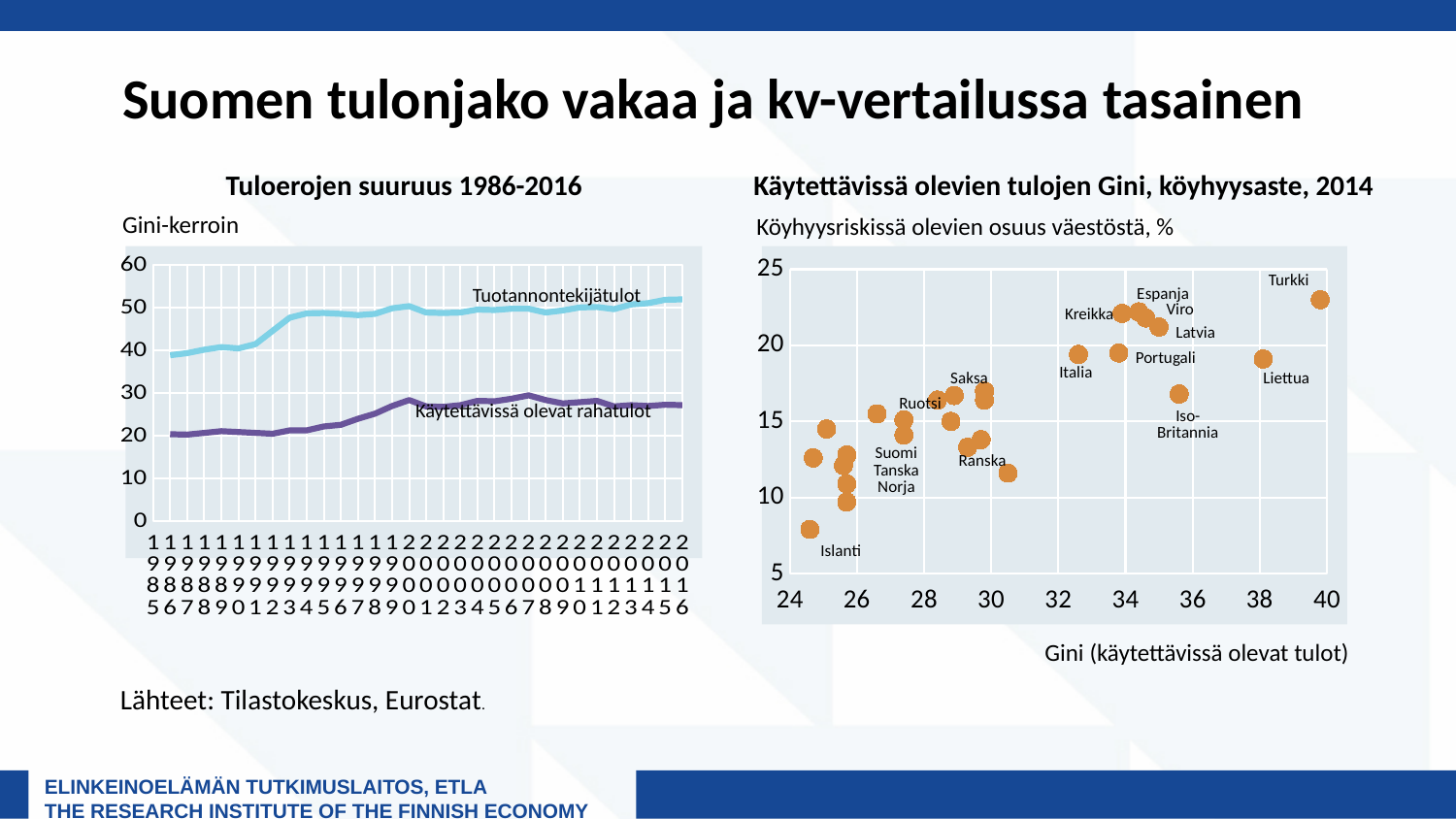
In the left chart, 'Tuloerojen suuruus 1986-2016', which series has the higher values throughout, Tuotannontekijätulot or Käytettävissä olevat rahatulot? Tuotannontekijätulot In the left chart, 'Tuloerojen suuruus 1986-2016', is the value for Käytettävissä olevat rahatulot in 1986 greater or less than 30? less What is the x-axis label of the right chart, 'Käytettävissä olevien tulojen Gini, köyhyysaste, 2014'? Gini (käytettävissä olevat tulot) In the right chart, 'Käytettävissä olevien tulojen Gini, köyhyysaste, 2014', is the poverty-risk share for Islanti greater or less than 10? less In the right chart, 'Käytettävissä olevien tulojen Gini, köyhyysaste, 2014', is the Gini value for Turkki greater or less than 38? greater In the left chart, 'Tuloerojen suuruus 1986-2016', does the Tuotannontekijätulot series rise or fall from 1986 to 2016? rise How many series are plotted in the left chart, 'Tuloerojen suuruus 1986-2016'? 2 What kind of chart is the left chart, 'Tuloerojen suuruus 1986-2016'? line chart What kind of chart is the right chart, 'Käytettävissä olevien tulojen Gini, köyhyysaste, 2014'? scatter chart In the right chart, 'Käytettävissä olevien tulojen Gini, köyhyysaste, 2014', which country has the highest share of population at risk of poverty? Turkki In the right chart, 'Käytettävissä olevien tulojen Gini, köyhyysaste, 2014', which country has the lowest share of population at risk of poverty? Islanti